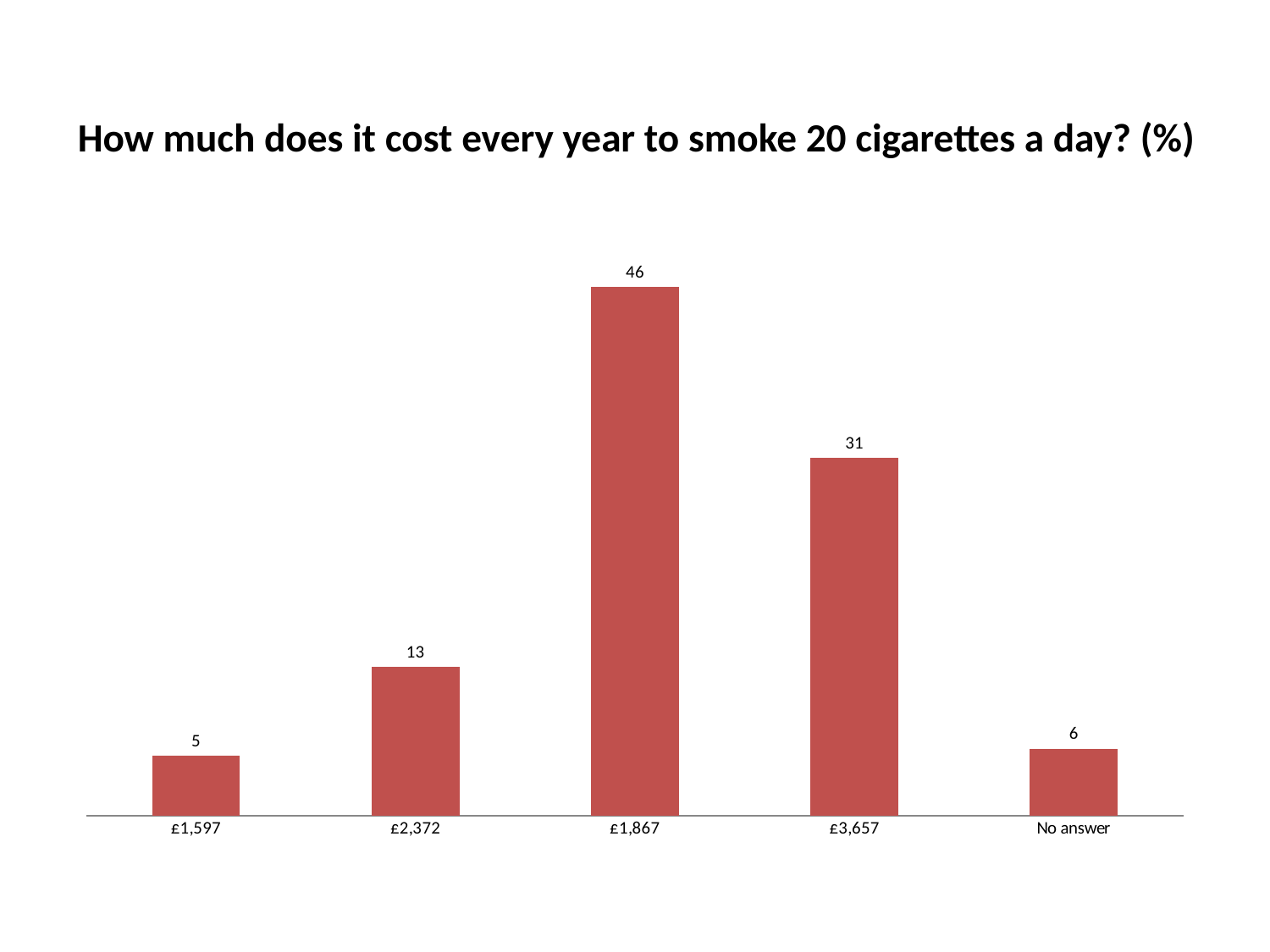
How many categories are shown on the x axis? 5 Which is larger, the value for £2,372 or the value for No answer? £2,372 What is the difference between the values for £1,867 and £3,657? 15 Which category has the highest value? £1,867 Which category has the lowest value? £1,597 What is the value for 'No answer'? 6 What is the difference between the values for £2,372 and £1,597? 8 What kind of chart is shown on the slide? Bar chart What percentage of respondents answered £1,867? 46 What is the title of the chart? How much does it cost every year to smoke 20 cigarettes a day? (%) What is the value for the £1,597 category? 5 What is the value for the £3,657 category? 31